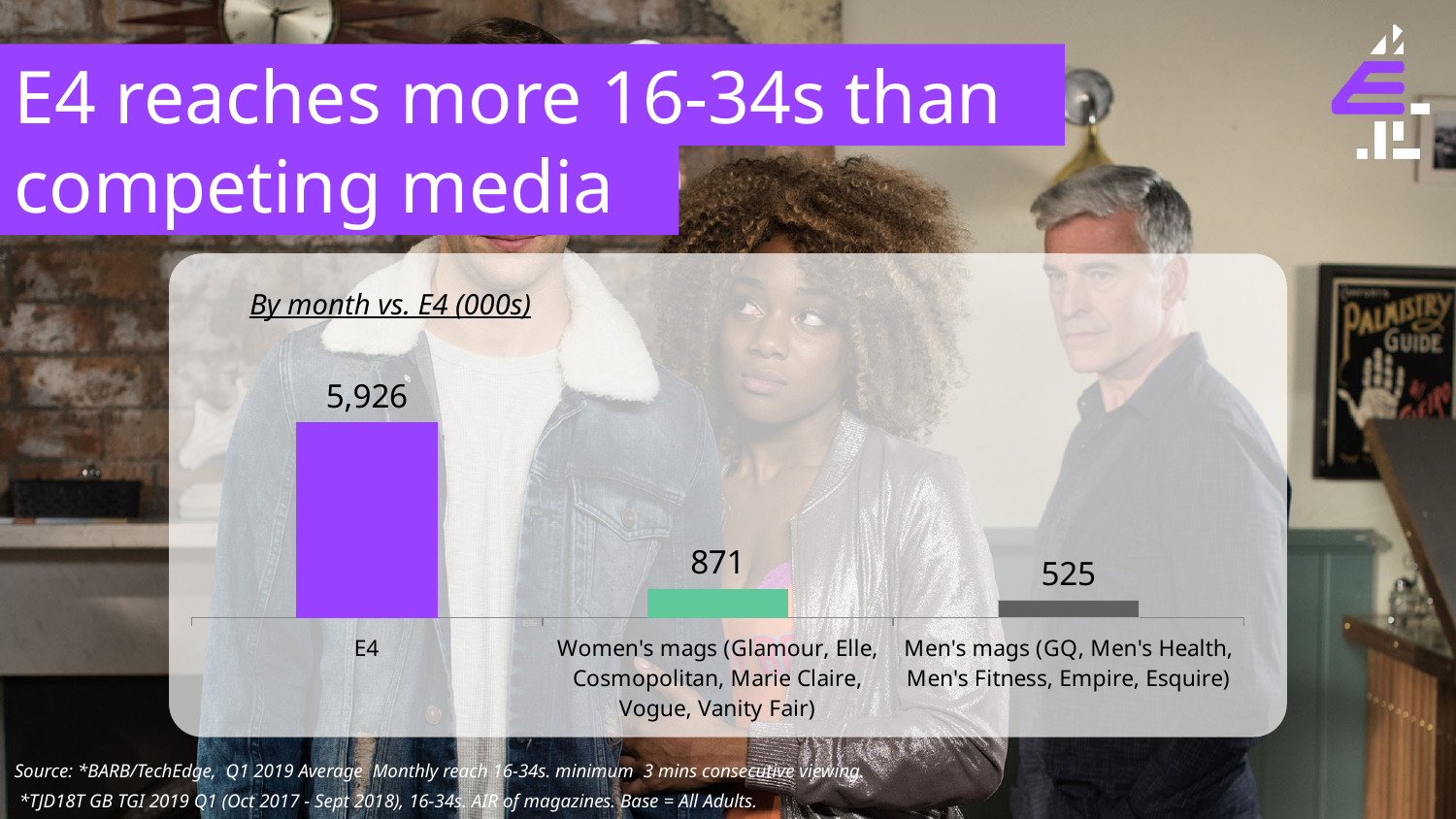
What is the difference between the value for E4 and the value for Women's mags? 5,055 What is the subtitle shown above the chart? By month vs. E4 (000s) Which is larger, the value for Women's mags or the value for Men's mags? Women's mags Which category has the highest value? E4 Do the values rise or fall from left to right across the categories? Fall What is the value for E4? 5,926 What is the value for Women's mags (Glamour, Elle, Cosmopolitan, Marie Claire, Vogue, Vanity Fair)? 871 Which category has the lowest value? Men's mags (GQ, Men's Health, Men's Fitness, Empire, Esquire) What kind of chart is shown on the slide? Bar chart How many categories are shown in the chart? 3 What is the value for Men's mags (GQ, Men's Health, Men's Fitness, Empire, Esquire)? 525 What is the difference between the value for Women's mags and the value for Men's mags? 346